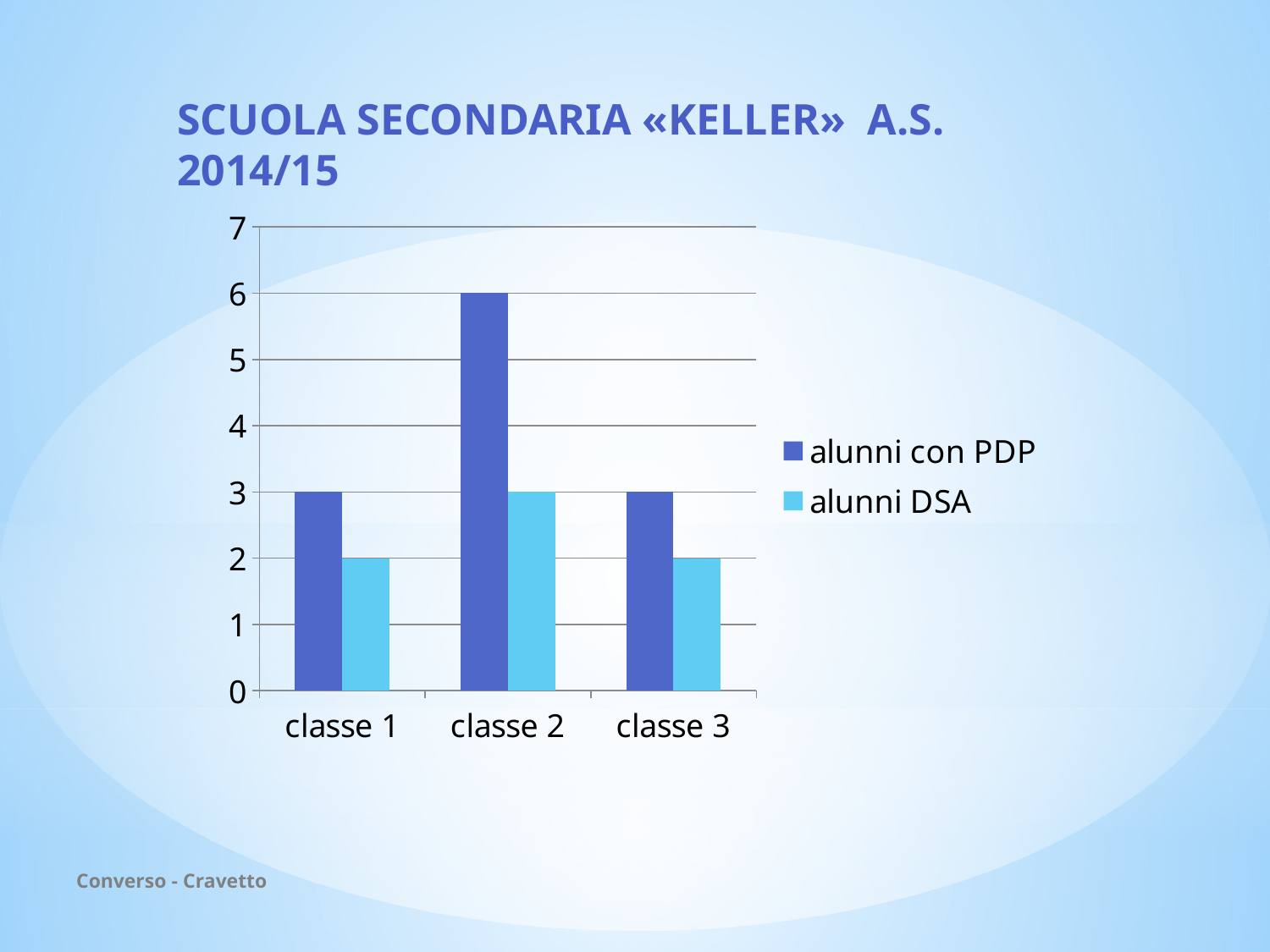
How many classes are shown on the x axis? 3 Is the value for alunni con PDP in classe 2 greater or less than 5? greater What is the value for alunni con PDP in classe 2? 6 What kind of chart is shown on the slide? bar chart What is the difference between alunni con PDP and alunni DSA in classe 2? 3 What is the difference between alunni con PDP in classe 2 and alunni con PDP in classe 3? 3 What is the value for alunni DSA in classe 1? 2 Which class has the highest value for alunni con PDP? classe 2 How many series does the legend list? 2 What is the value for alunni DSA in classe 2? 3 Which class has the highest value for alunni DSA? classe 2 Which is larger in classe 3: alunni con PDP or alunni DSA? alunni con PDP